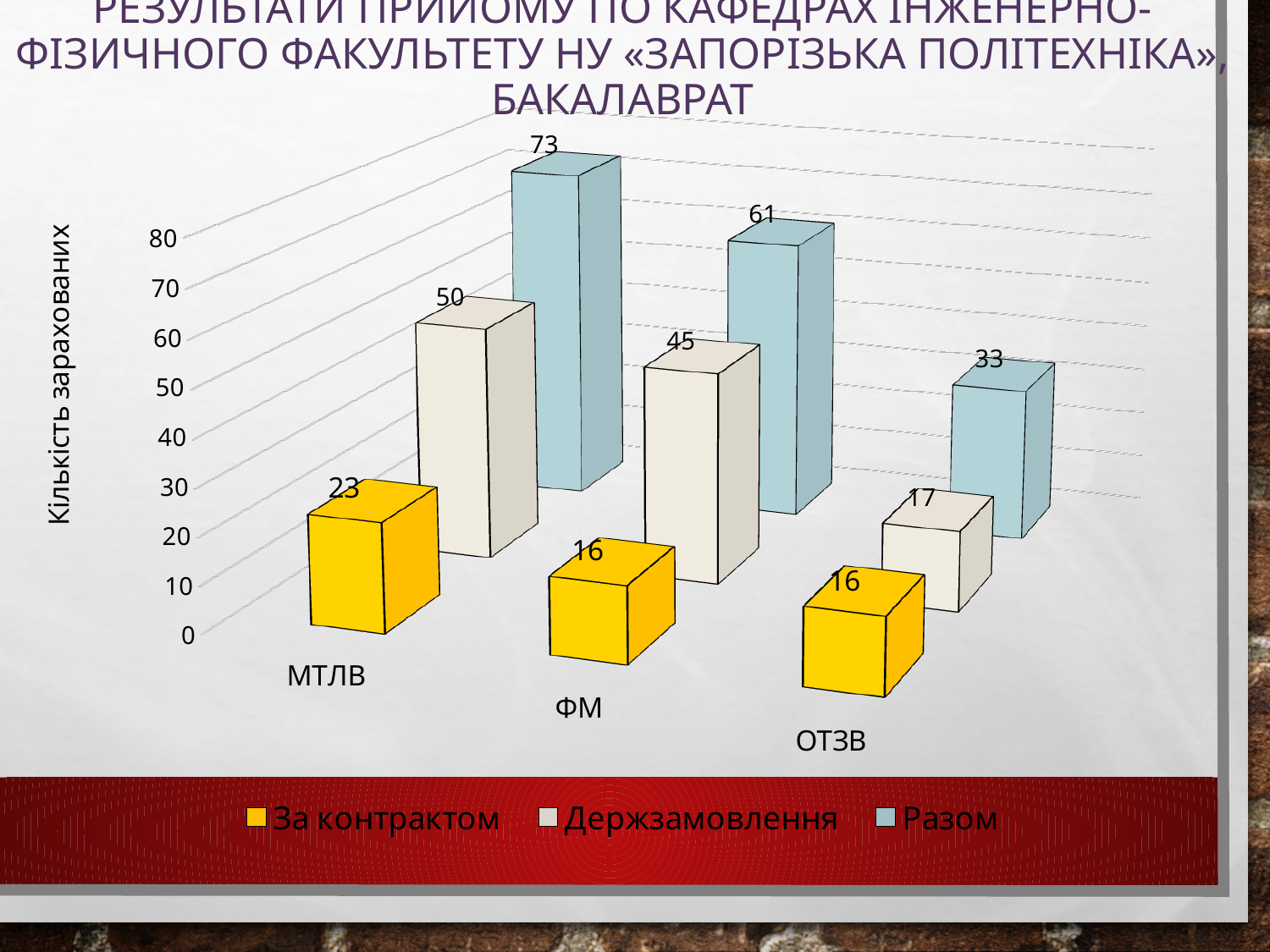
What kind of chart is shown on the slide? Bar chart Which category has the highest value for Разом? МТЛВ What is the value for Разом for МТЛВ? 73 Which is larger: Держзамовлення for МТЛВ or Держзамовлення for ФМ? Держзамовлення for МТЛВ Do the Разом values rise or fall from МТЛВ to ОТЗВ? Fall How many series does the legend list? 3 What is the difference between the Разом values for МТЛВ and ОТЗВ? 40 What is the value for Держзамовлення for ФМ? 45 What is the value for За контрактом for ОТЗВ? 16 Which category has the lowest value for Держзамовлення? ОТЗВ How many categories are shown on the x axis? 3 What is the label of the vertical axis? Кількість зарахованих